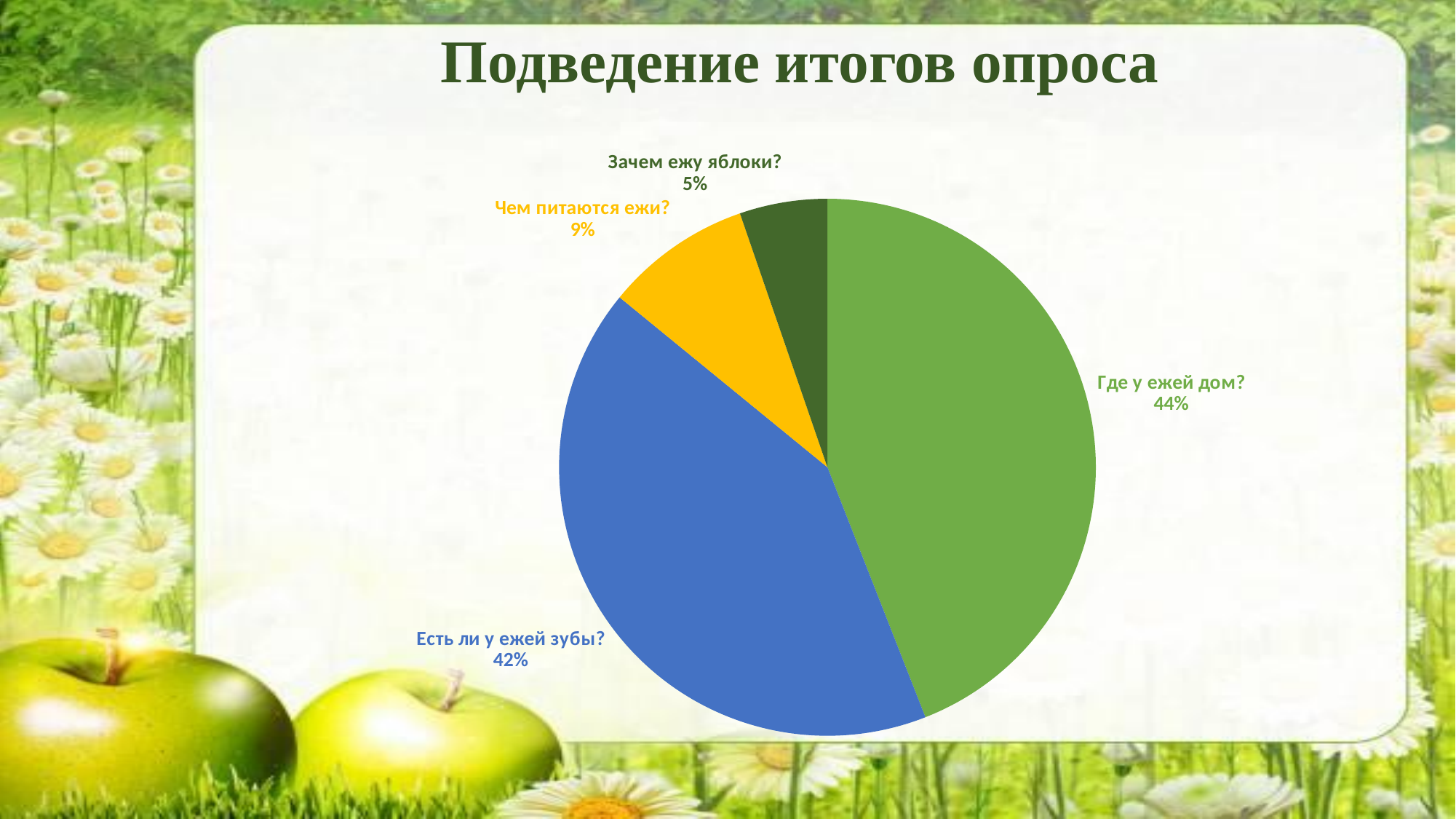
What is the title of the slide containing the pie chart? Подведение итогов опроса Which slice of the pie is the smallest? Зачем ежу яблоки? What is the difference in percentage points between "Чем питаются ежи?" and "Зачем ежу яблоки?"? 4% How many slices does the pie chart have? 4 What share of the pie does "Зачем ежу яблоки?" have? 5% Which slice of the pie is the largest? Где у ежей дом? What share of the pie does "Есть ли у ежей зубы?" have? 42% What is the difference in percentage points between "Где у ежей дом?" and "Есть ли у ежей зубы?"? 2% Which is larger: the share for "Чем питаются ежи?" or for "Зачем ежу яблоки?"? Чем питаются ежи? What share of the pie does "Чем питаются ежи?" have? 9% What kind of chart is shown on the slide? pie chart